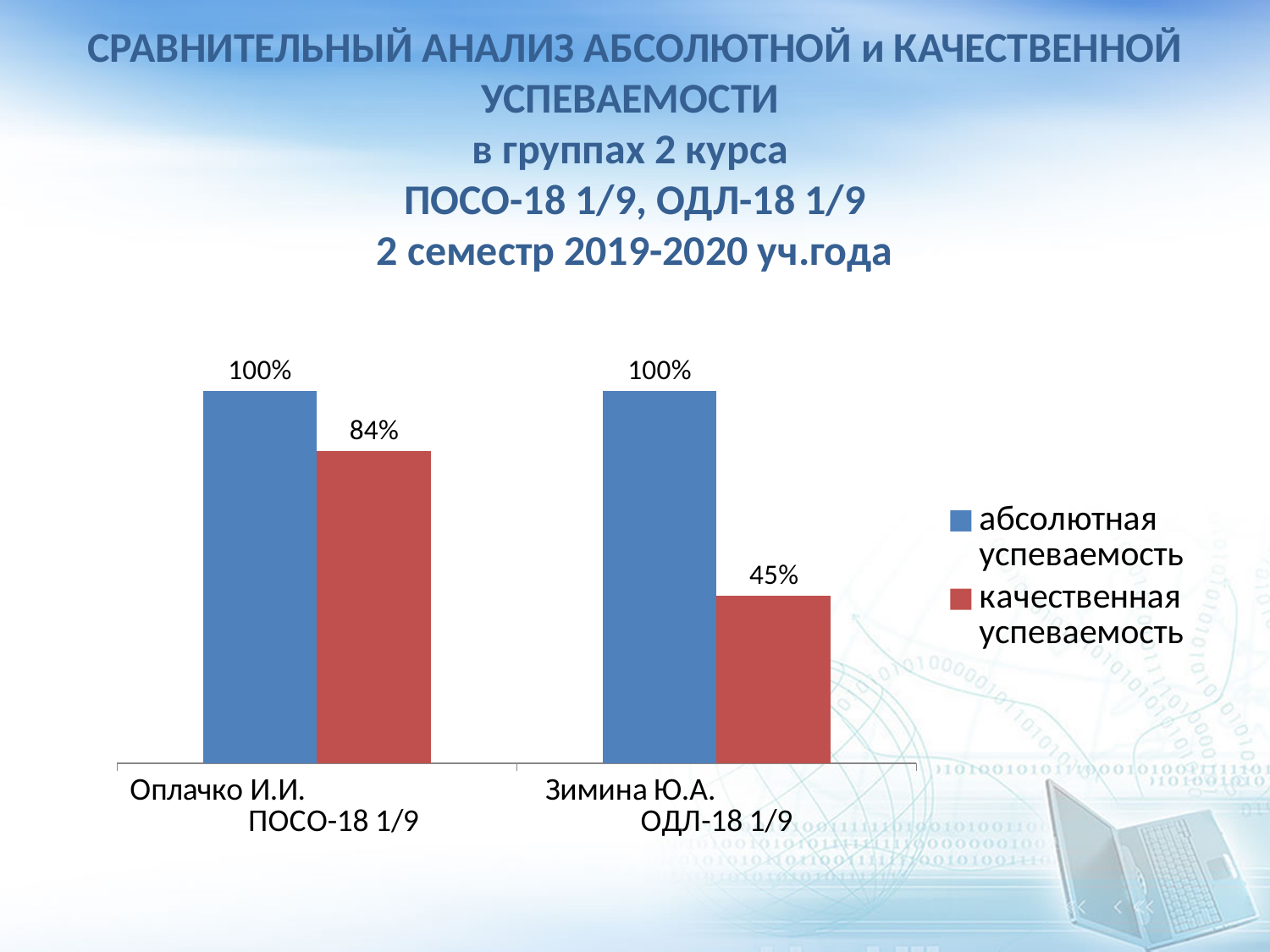
For Зимина Ю.А. ОДЛ-18 1/9, what is the difference between абсолютная успеваемость and качественная успеваемость? 55% Is the качественная успеваемость for Оплачко И.И. ПОСО-18 1/9 larger or smaller than that for Зимина Ю.А. ОДЛ-18 1/9? larger How many groups (categories) are shown on the x axis? 2 Which group has the higher качественная успеваемость? Оплачко И.И. ПОСО-18 1/9 What is the абсолютная успеваемость value for Оплачко И.И. ПОСО-18 1/9? 100% What is the difference in качественная успеваемость between Оплачко И.И. ПОСО-18 1/9 and Зимина Ю.А. ОДЛ-18 1/9? 39% What is the качественная успеваемость value for Зимина Ю.А. ОДЛ-18 1/9? 45% What type of chart is shown on the slide? bar chart Which group has the lowest качественная успеваемость? Зимина Ю.А. ОДЛ-18 1/9 What is the абсолютная успеваемость value for Зимина Ю.А. ОДЛ-18 1/9? 100% How many series does the legend list? 2 What is the качественная успеваемость value for Оплачко И.И. ПОСО-18 1/9? 84%